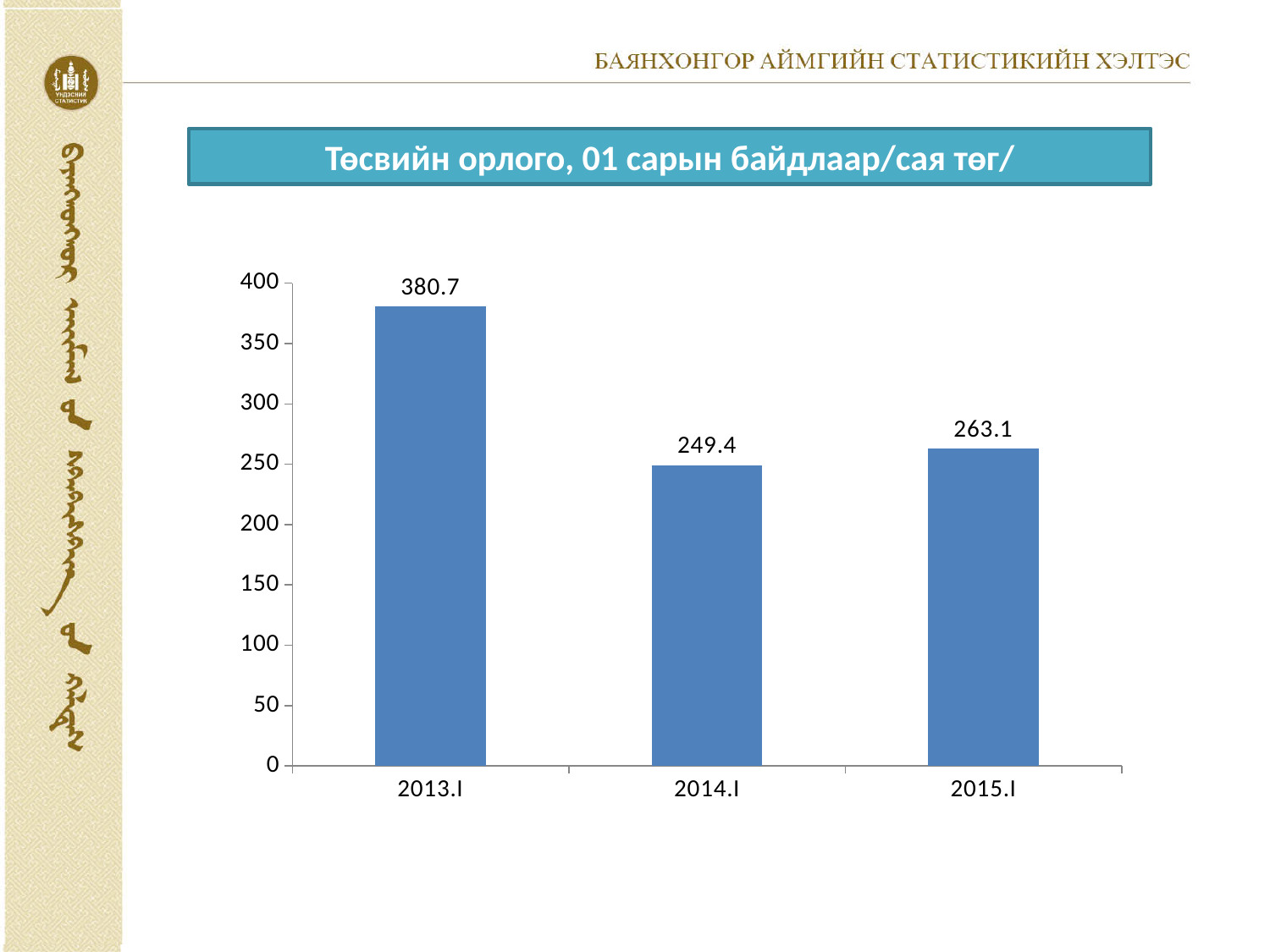
What is the title of the chart? Төсвийн орлого, 01 сарын байдлаар/сая төг/ Which is larger, the value for 2013.I or the value for 2015.I? 2013.I Which category has the lowest value? 2014.I What is the value for 2015.I? 263.1 What is the difference between the values for 2015.I and 2014.I? 13.7 What is the value for 2014.I? 249.4 What is the value for 2013.I? 380.7 Is the value for 2014.I greater or less than 300? less What kind of chart is shown on the slide? bar chart What is the difference between the values for 2013.I and 2014.I? 131.3 How many categories are shown on the x axis? 3 Which category has the highest value? 2013.I